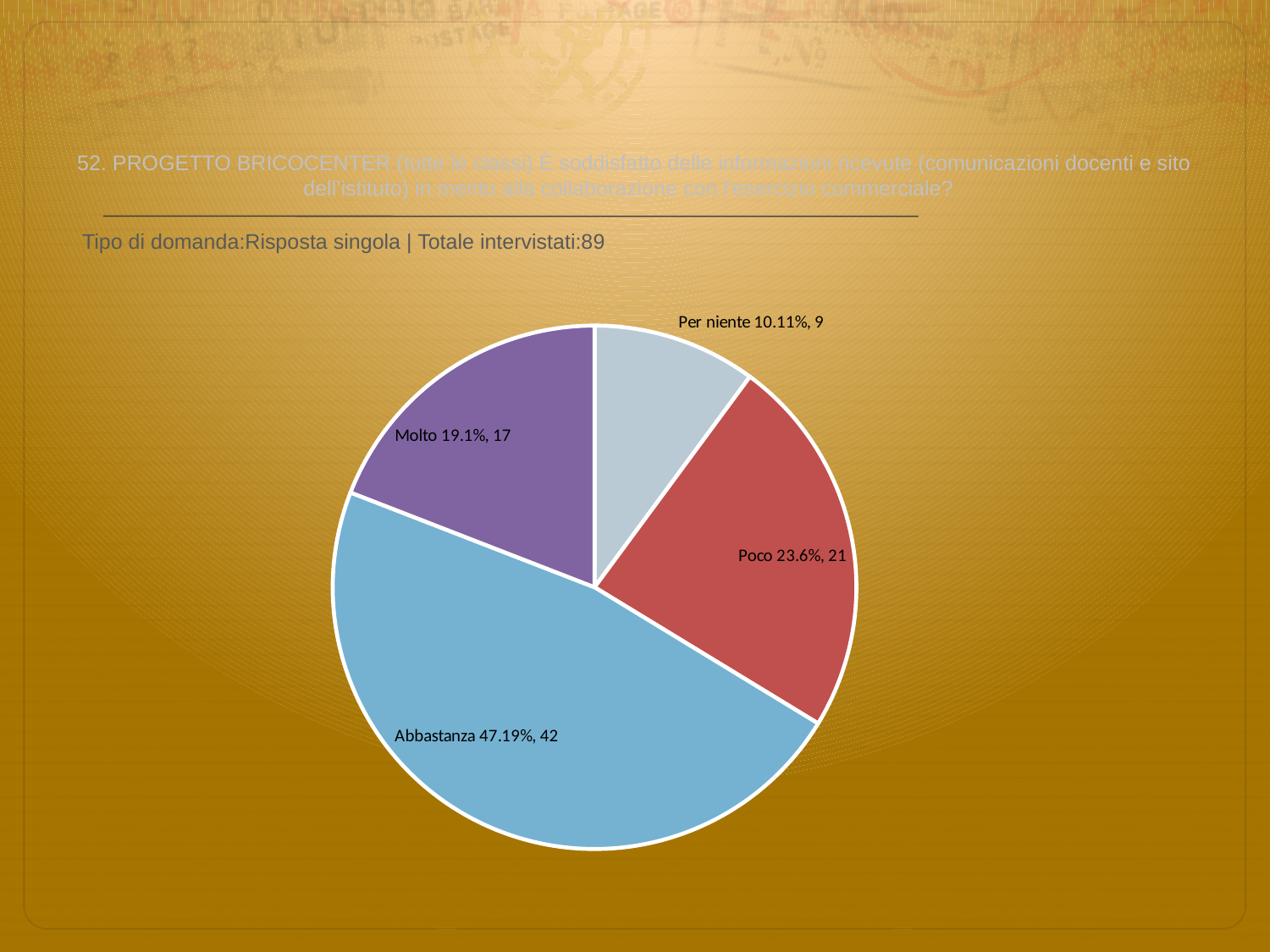
What colour is the 'Abbastanza' slice? light blue What is the difference in respondent count between 'Abbastanza' and 'Poco'? 21 How many respondents answered 'Per niente'? 9 Which slice is larger, 'Molto' or 'Poco'? Poco What kind of chart is shown on the slide? pie chart What percentage is shown for the 'Abbastanza' slice? 47.19% How many respondents answered 'Poco'? 21 What percentage is shown for the 'Molto' slice? 19.1% Which category has the largest slice of the pie? Abbastanza How many slices does the pie chart have? 4 Which category has the smallest slice of the pie? Per niente What is the total number of respondents shown on the slide? 89